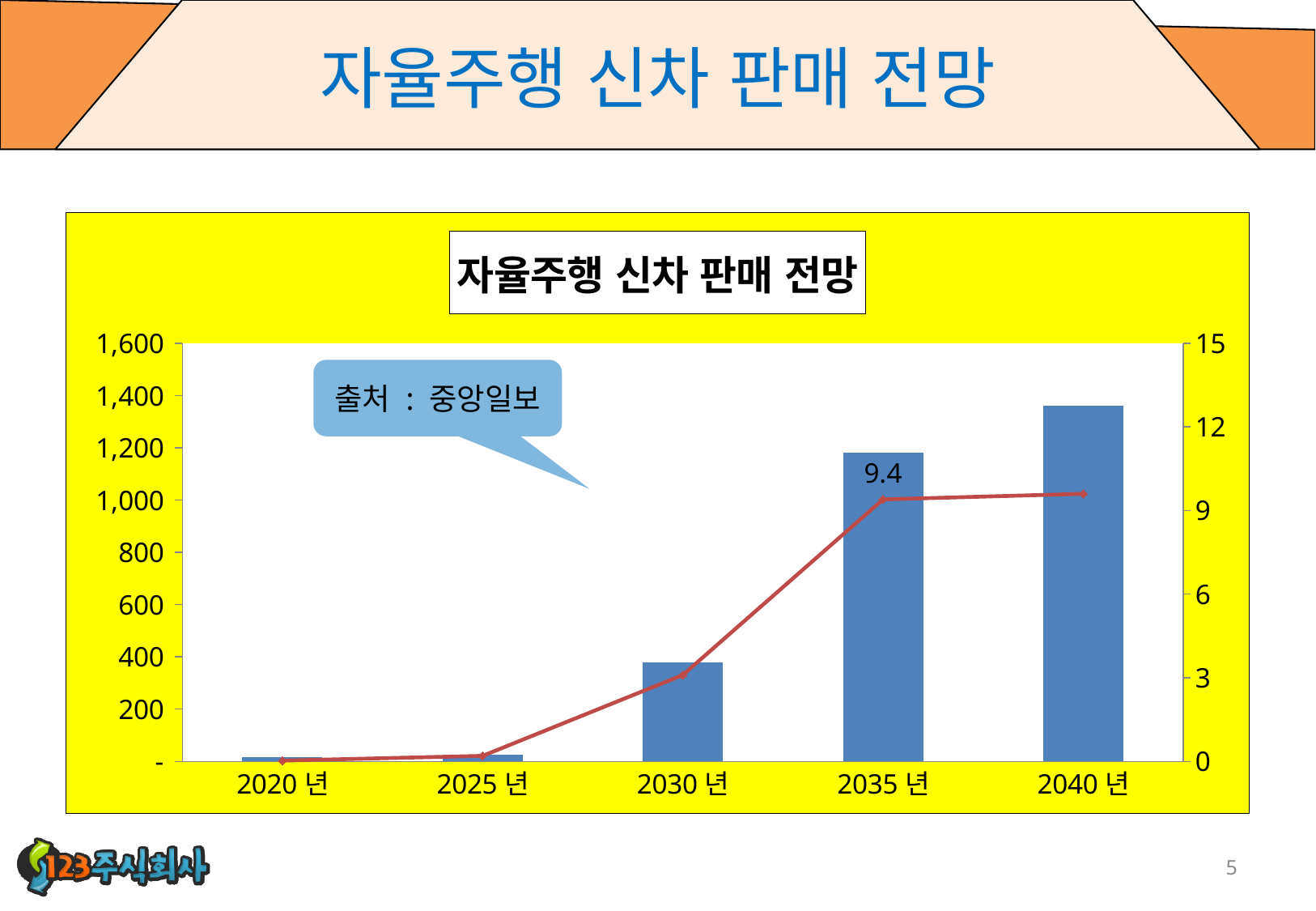
Is the line value for 2030 년 greater or less than 6 on the right axis? less Is the bar value for 2035 년 greater or less than 1,000? greater What source is cited in the callout on the chart? 중앙일보 What value is labelled on the line at 2035 년? 9.4 Do the bar values rise or fall from 2020 년 to 2040 년? rise Which bar is taller, 2030 년 or 2035 년? 2035 년 Which year has the tallest bar? 2040 년 Is the bar value for 2030 년 greater or less than 600? less How many year categories are shown on the x axis? 5 What is the title of the chart? 자율주행 신차 판매 전망 What kind of chart is shown on the slide? A combination bar and line chart